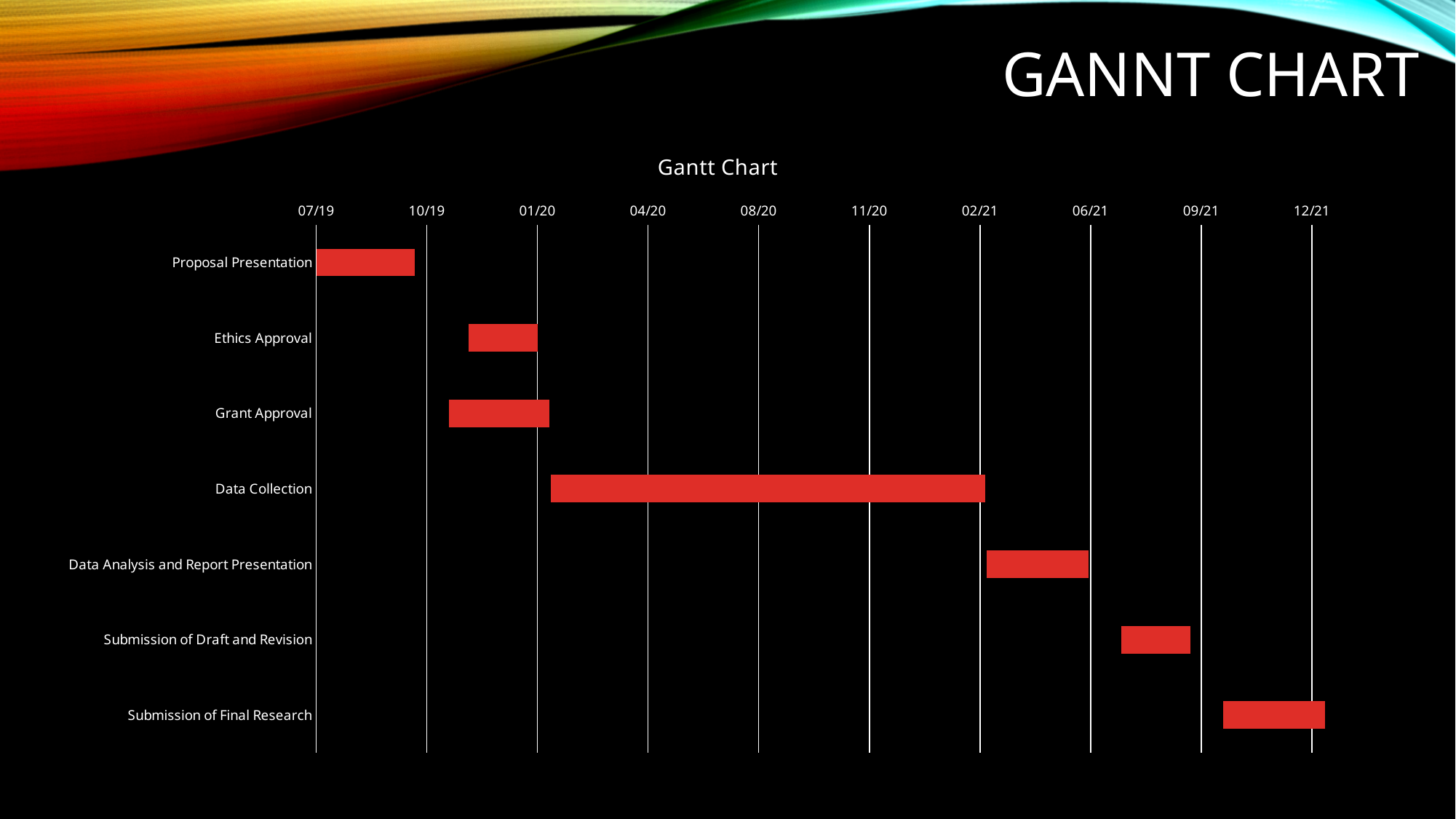
Does the Data Collection bar start before or after 01/20? after Does the Data Analysis and Report Presentation bar start before or after 02/21? after Which bar is longer, Proposal Presentation or Ethics Approval? Proposal Presentation Does the Proposal Presentation bar end before or after 10/19? before Which task has the longest bar in the Gantt chart? Data Collection What is the title printed above the chart? Gantt Chart Which bar is longer, Data Collection or Grant Approval? Data Collection Which task is the first to start on the timeline? Proposal Presentation How many tasks are listed on the vertical axis of the Gantt chart? 7 What is the first date label shown on the horizontal axis? 07/19 What kind of chart is shown on the slide? Bar chart (Gantt chart) Which task is the last one on the timeline? Submission of Final Research